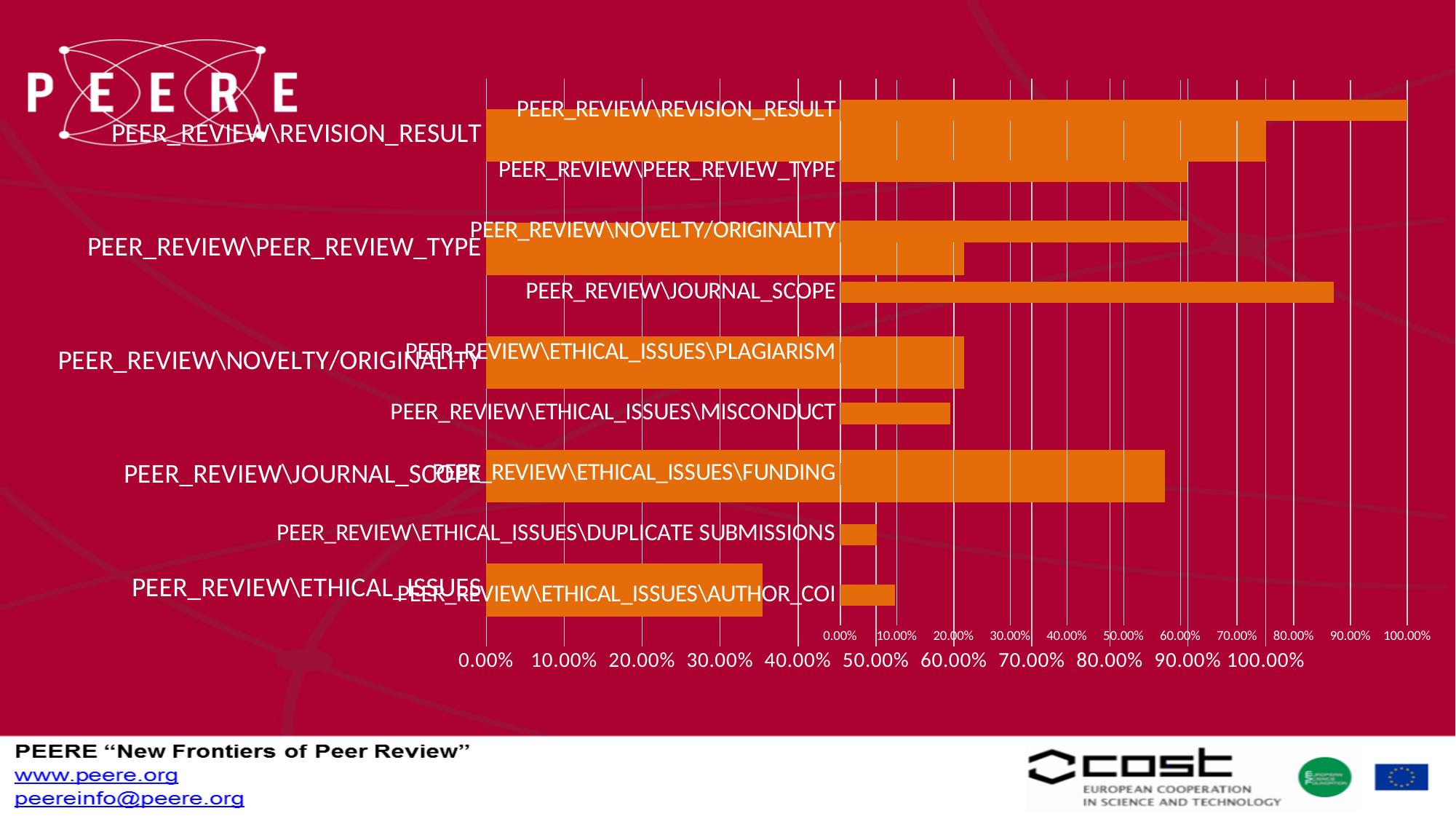
What colour are the bars in the charts? Orange In the larger chart on the left, how many categories are plotted? 5 In the larger chart on the left, which category has the lowest value? PEER_REVIEW\ETHICAL_ISSUES In the smaller chart on the right, is the value for PEER_REVIEW\JOURNAL_SCOPE greater or less than 80.00%? greater In the larger chart on the left, is the value for PEER_REVIEW\ETHICAL_ISSUES greater or less than 50.00%? less What kind of chart is shown on the slide? Bar chart In the smaller chart on the right, how many categories are plotted? 9 In the smaller chart on the right, is the value for PEER_REVIEW\ETHICAL_ISSUES\DUPLICATE SUBMISSIONS greater or less than 10.00%? less In the smaller chart on the right, which category has the highest value? PEER_REVIEW\REVISION_RESULT In the smaller chart on the right, which is larger: PEER_REVIEW\JOURNAL_SCOPE or PEER_REVIEW\NOVELTY/ORIGINALITY? PEER_REVIEW\JOURNAL_SCOPE